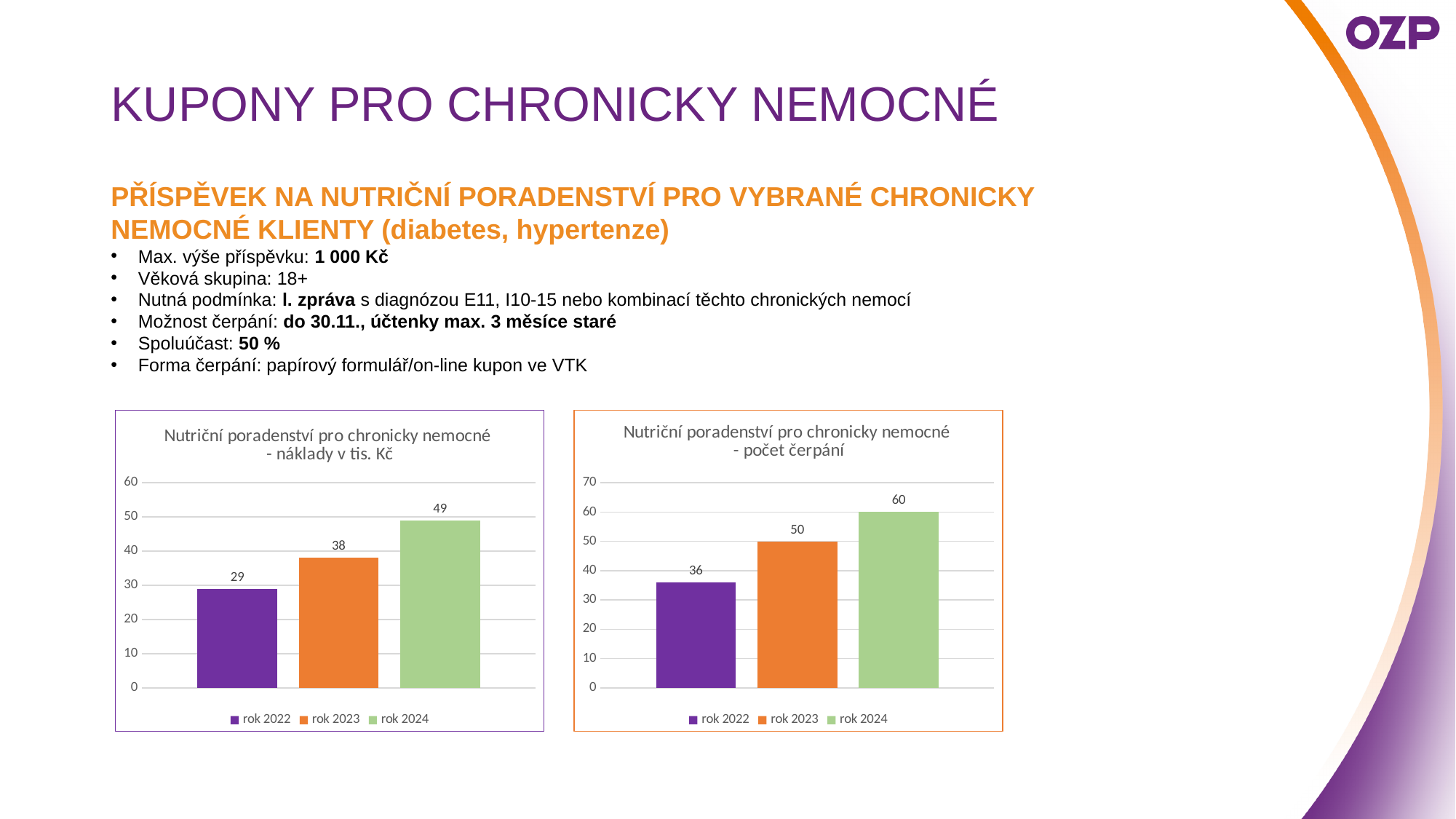
In the left chart (náklady v tis. Kč), what is the difference between rok 2024 and rok 2022? 20 In the left chart (náklady v tis. Kč), which year has the highest value? rok 2024 What kind of chart is the right chart (počet čerpání)? bar chart In the right chart (počet čerpání), what is the value for rok 2024? 60 How many series does the legend of the left chart (náklady v tis. Kč) list? 3 In the right chart (počet čerpání), which is larger: rok 2022 or rok 2023? rok 2023 In the left chart (náklady v tis. Kč), is the value for rok 2022 greater or less than 30? less In the right chart (počet čerpání), what is the difference between rok 2023 and rok 2022? 14 In the left chart (náklady v tis. Kč), do the values rise or fall from rok 2022 to rok 2024? rise In the right chart (počet čerpání), which year has the lowest value? rok 2022 How many bars are plotted in the right chart (počet čerpání)? 3 In the left chart (náklady v tis. Kč), what is the value for rok 2023? 38